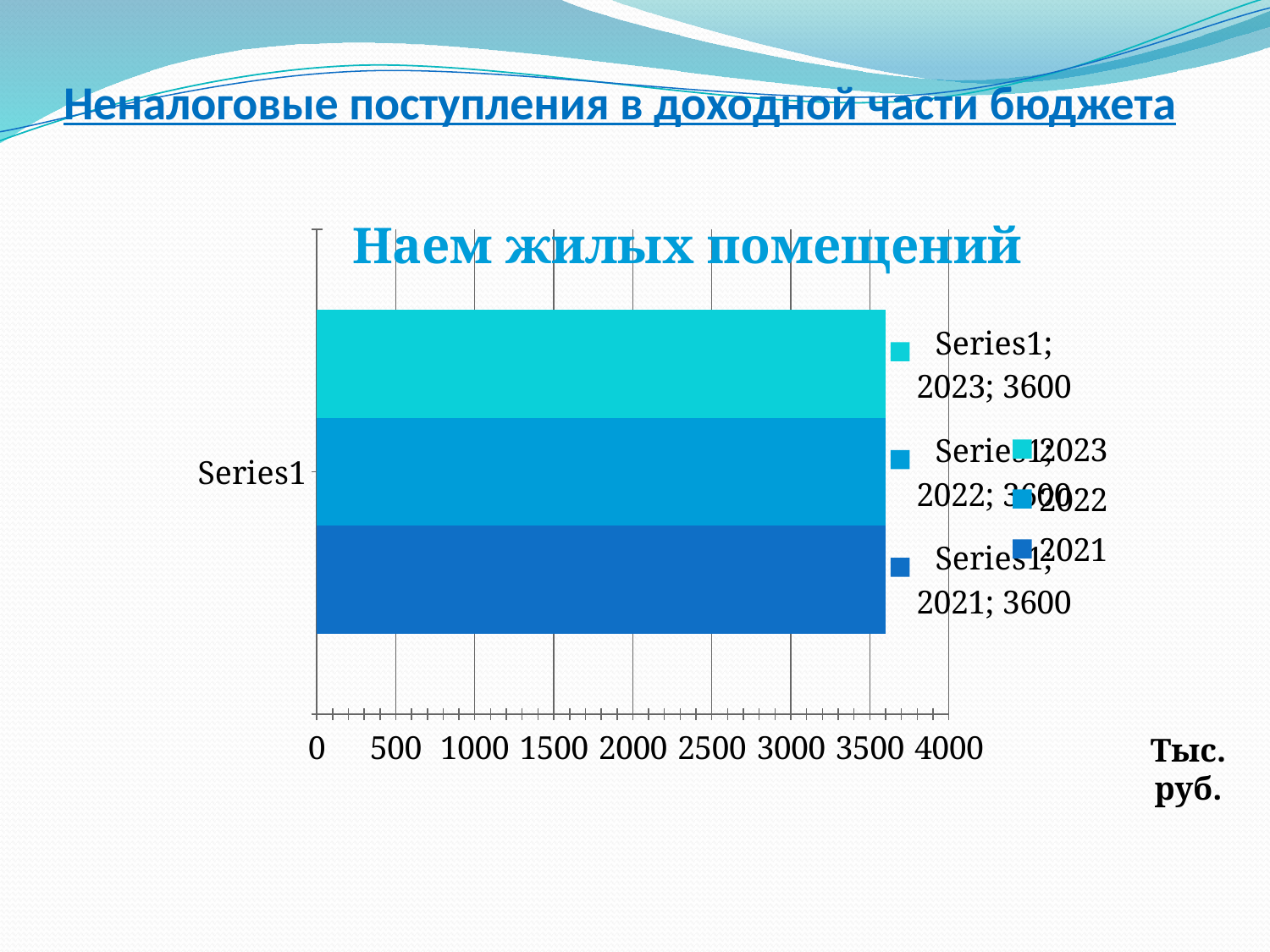
What is the title of the chart? Наем жилых помещений How many entries does the legend list? 3 Do the values change from 2021 to 2023? No, they stay the same How many bars are plotted in the chart? 3 What is the value for 2023 in the chart? 3600 What kind of chart is shown on the slide? bar chart Is the value for 2021 greater or less than 4000? less What is the difference between the values for 2023 and 2021? 0 Is the value for 2022 greater or less than 3000? greater What is the value for 2022 in the chart? 3600 What is the value for 2021 in the chart? 3600 What unit is indicated next to the chart? Тыс. руб.